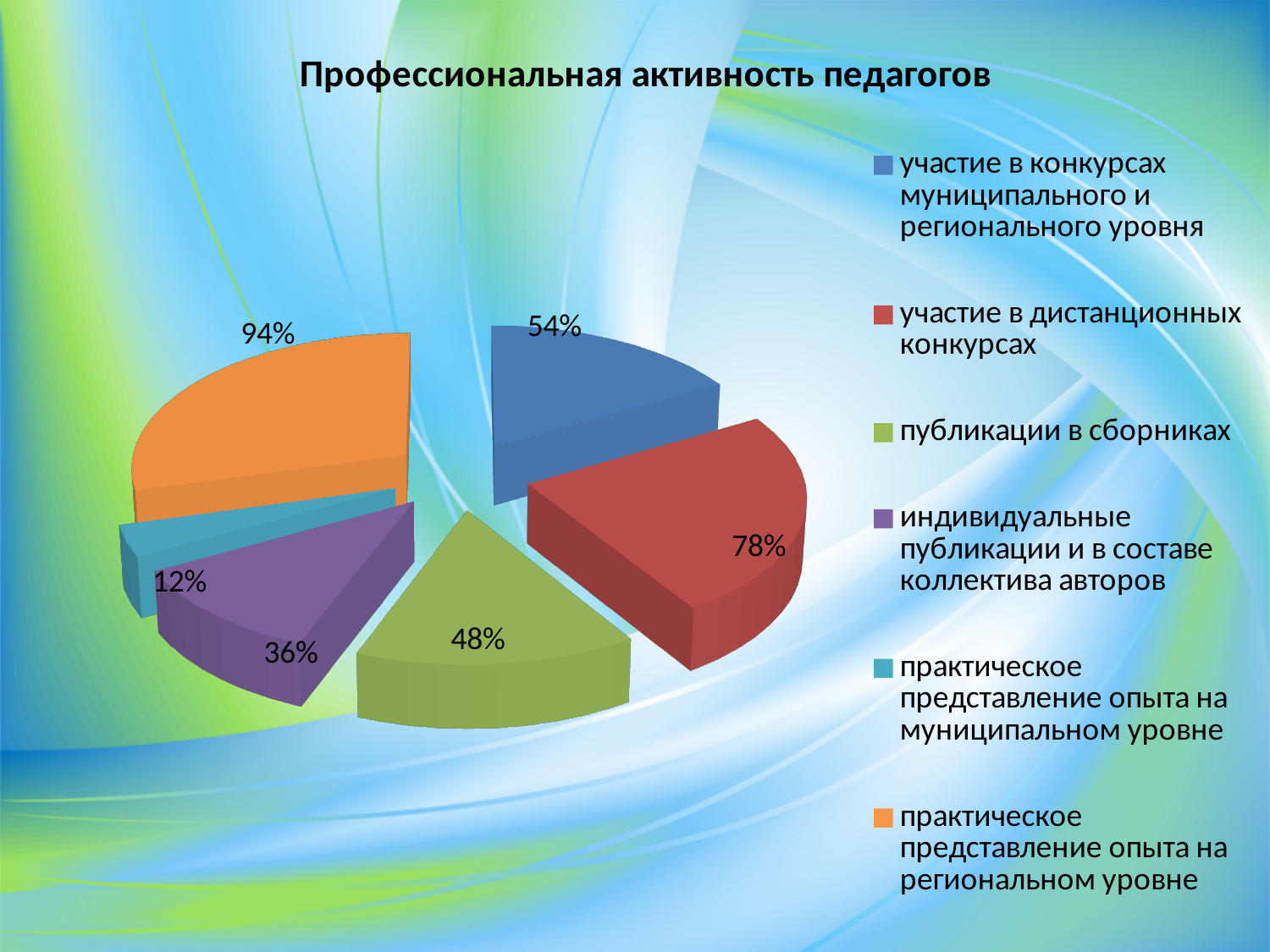
How many slices does the pie chart have? 6 What value is shown for "практическое представление опыта на муниципальном уровне"? 12% How many categories does the legend list? 6 Which category has the highest value? практическое представление опыта на региональном уровне What value is shown for "публикации в сборниках"? 48% What value is shown for "участие в дистанционных конкурсах"? 78% What is the difference between the values for "участие в дистанционных конкурсах" and "публикации в сборниках"? 30% What value is shown for "индивидуальные публикации и в составе коллектива авторов"? 36% What is the title of the chart? Профессиональная активность педагогов What kind of chart is shown on the slide? pie chart What value is shown for "участие в конкурсах муниципального и регионального уровня"? 54% Which category has the lowest value? практическое представление опыта на муниципальном уровне